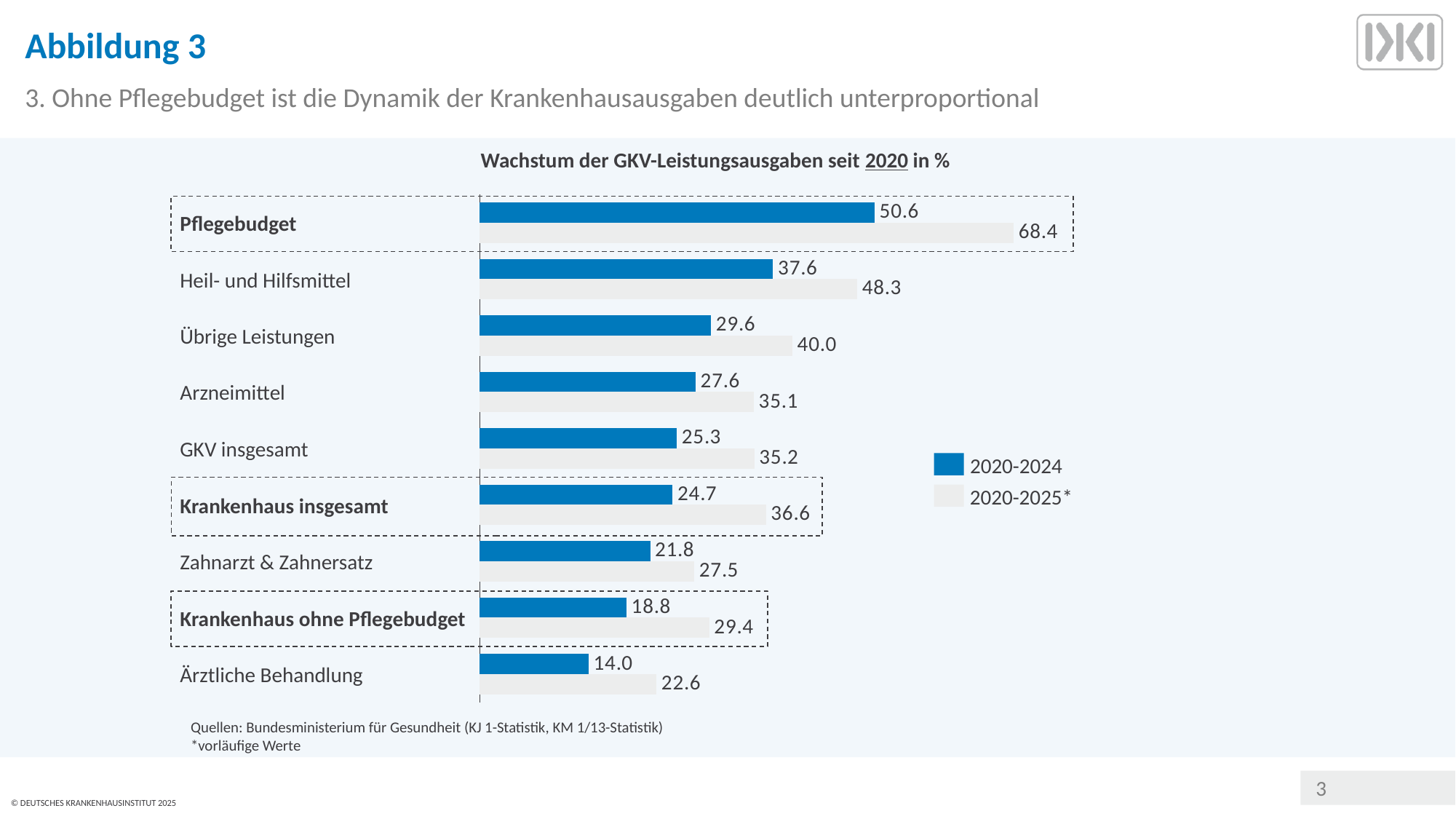
What is the difference between the 2020-2025* and 2020-2024 values for Heil- und Hilfsmittel? 10.7 What is the 2020-2024 value for Pflegebudget? 50.6 Which category has the lowest 2020-2024 value? Ärztliche Behandlung Which category has the highest 2020-2025* value? Pflegebudget What kind of chart is shown on the slide? Bar chart Which is larger: the 2020-2024 value for Arzneimittel or for Zahnarzt & Zahnersatz? Arzneimittel What is the 2020-2025* value for Krankenhaus ohne Pflegebudget? 29.4 What is the title of the chart? Wachstum der GKV-Leistungsausgaben seit 2020 in % How many categories are shown in the chart? 9 How many series does the legend list? 2 What is the 2020-2025* value for GKV insgesamt? 35.2 What is the difference between the 2020-2024 values for Krankenhaus insgesamt and Krankenhaus ohne Pflegebudget? 5.9